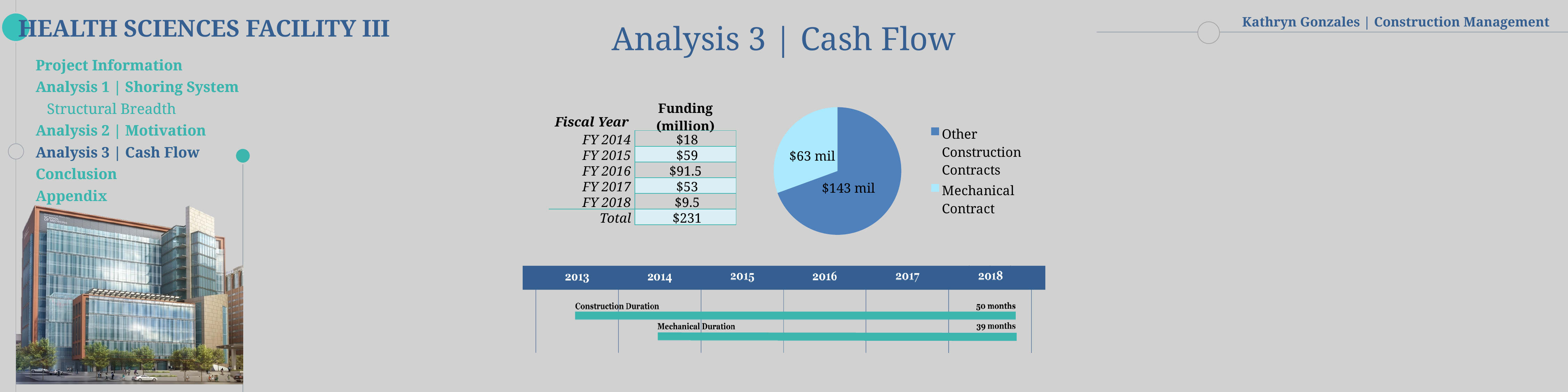
What kind of chart is shown on the slide? pie chart In the pie chart, what is the value for Other Construction Contracts? $143 mil Which slice of the pie chart is the smallest? Mechanical Contract What is the difference between the Other Construction Contracts value and the Mechanical Contract value in the pie chart? $80 mil In the pie chart, what is the value for Mechanical Contract? $63 mil Which slice of the pie chart is the largest? Other Construction Contracts How many slices does the pie chart have? 2 How many entries does the pie chart legend list? 2 In the pie chart, which is larger: Other Construction Contracts or Mechanical Contract? Other Construction Contracts Is the value for Mechanical Contract in the pie chart greater or less than $100 mil? less What colour is the Mechanical Contract slice in the pie chart? light blue What is the combined total of the two slices in the pie chart? $206 mil